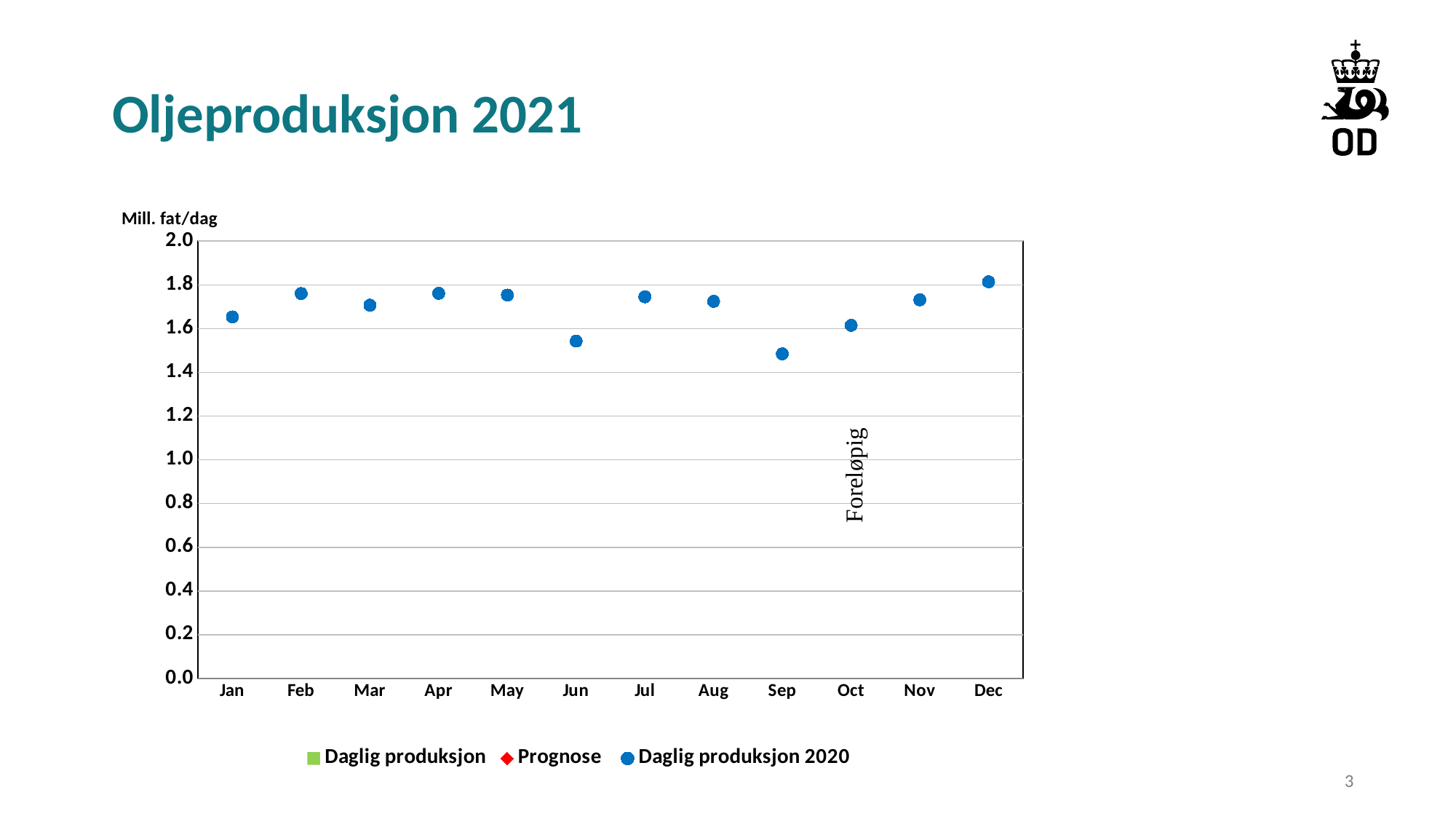
Which is larger, the value for Jan or the value for Feb? Feb How many months are shown on the x axis? 12 What unit is shown on the y axis label? Mill. fat/dag What kind of chart is shown on the slide? scatter chart Is the value for Sep greater or less than 1.6? less Is the value for Oct greater or less than 1.8? less Which month has the highest value for Daglig produksjon 2020? Dec Which month has the lowest value for Daglig produksjon 2020? Sep Which is larger, the value for Jun or the value for Sep? Jun Is the value for Jan greater or less than 1.6? greater How many series does the legend list? 3